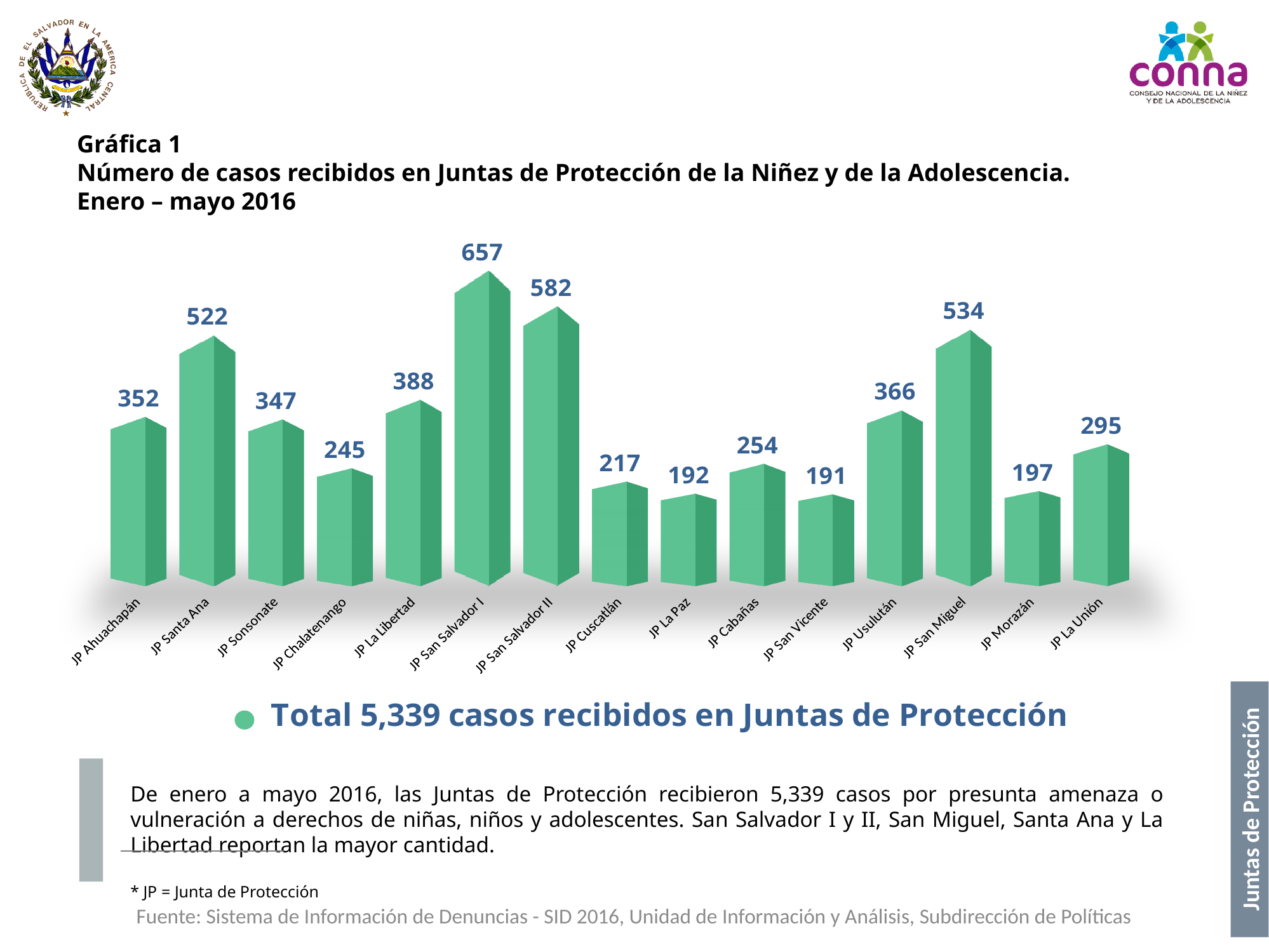
What is the difference in cases between JP Santa Ana and JP Sonsonate? 175 What kind of chart is shown on the slide? Bar chart Which received more cases, JP Usulután or JP La Libertad? JP La Libertad What is the difference in cases between JP San Salvador I and JP San Salvador II? 75 Which Junta de Protección received the lowest number of cases? JP San Vicente How many Juntas de Protección are shown on the chart? 15 Which received more cases, JP San Miguel or JP Santa Ana? JP San Miguel What is the number of cases received by JP San Salvador I? 657 Which Junta de Protección received the highest number of cases? JP San Salvador I What total number of cases received in Juntas de Protección is stated below the chart? 5,339 What is the number of cases received by JP La Unión? 295 What is the number of cases received by JP Chalatenango? 245